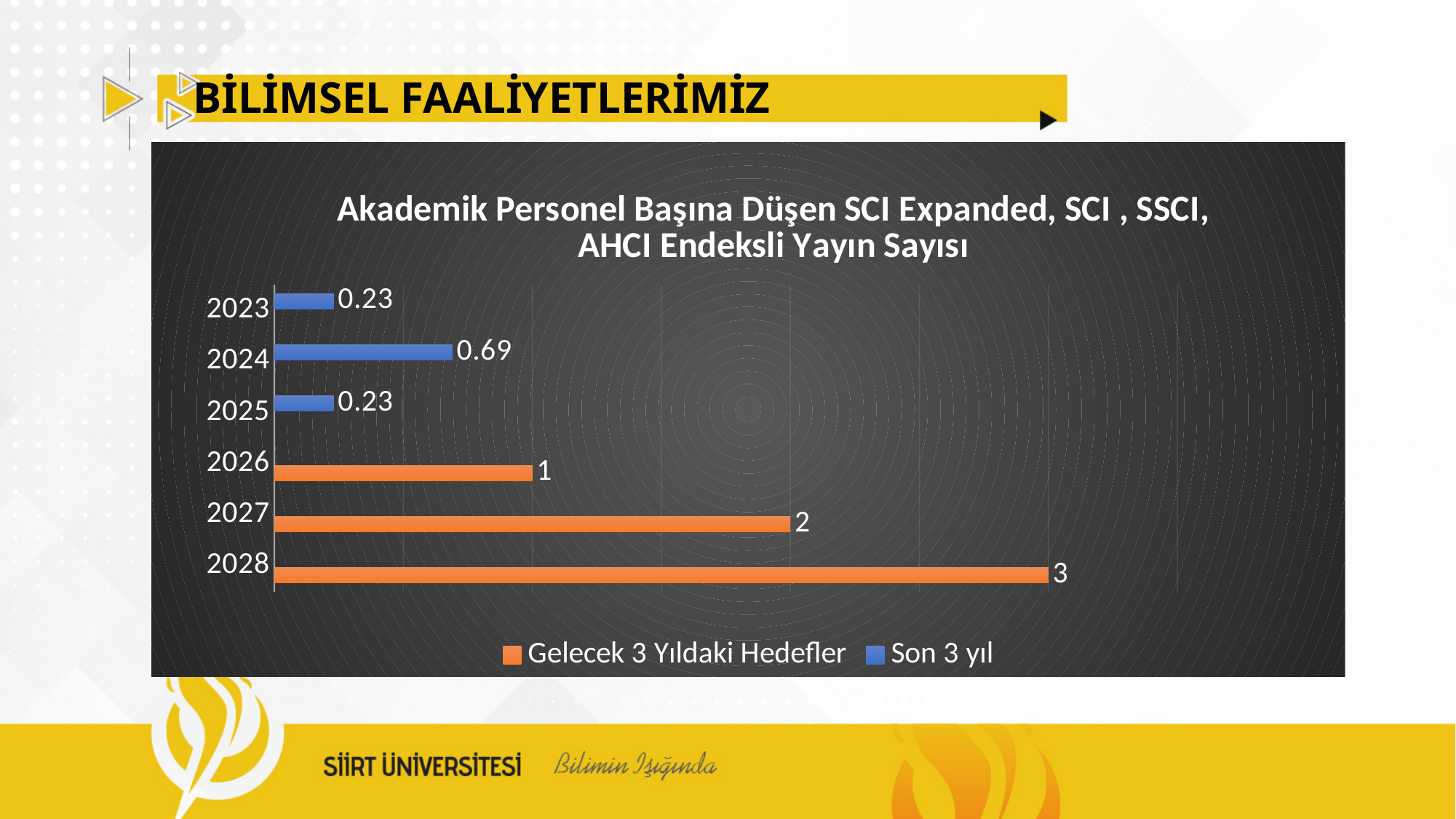
What is the difference between the values for 2028 and 2027? 1 Which year has the highest value among the 'Son 3 yıl' series? 2024 Which is larger, the value for 2024 or the value for 2025? 2024 What is the value for 2024 in the chart? 0.69 What is the value for 2026 in the chart? 1 What kind of chart is shown on the slide? Bar chart Which series is shown in orange according to the legend? Gelecek 3 Yıldaki Hedefler What is the value for 2028 in the chart? 3 Which year has the highest value in the chart? 2028 How many years are shown on the chart's axis? 6 What is the difference between the values for 2024 and 2023? 0.46 How many series does the legend list? 2